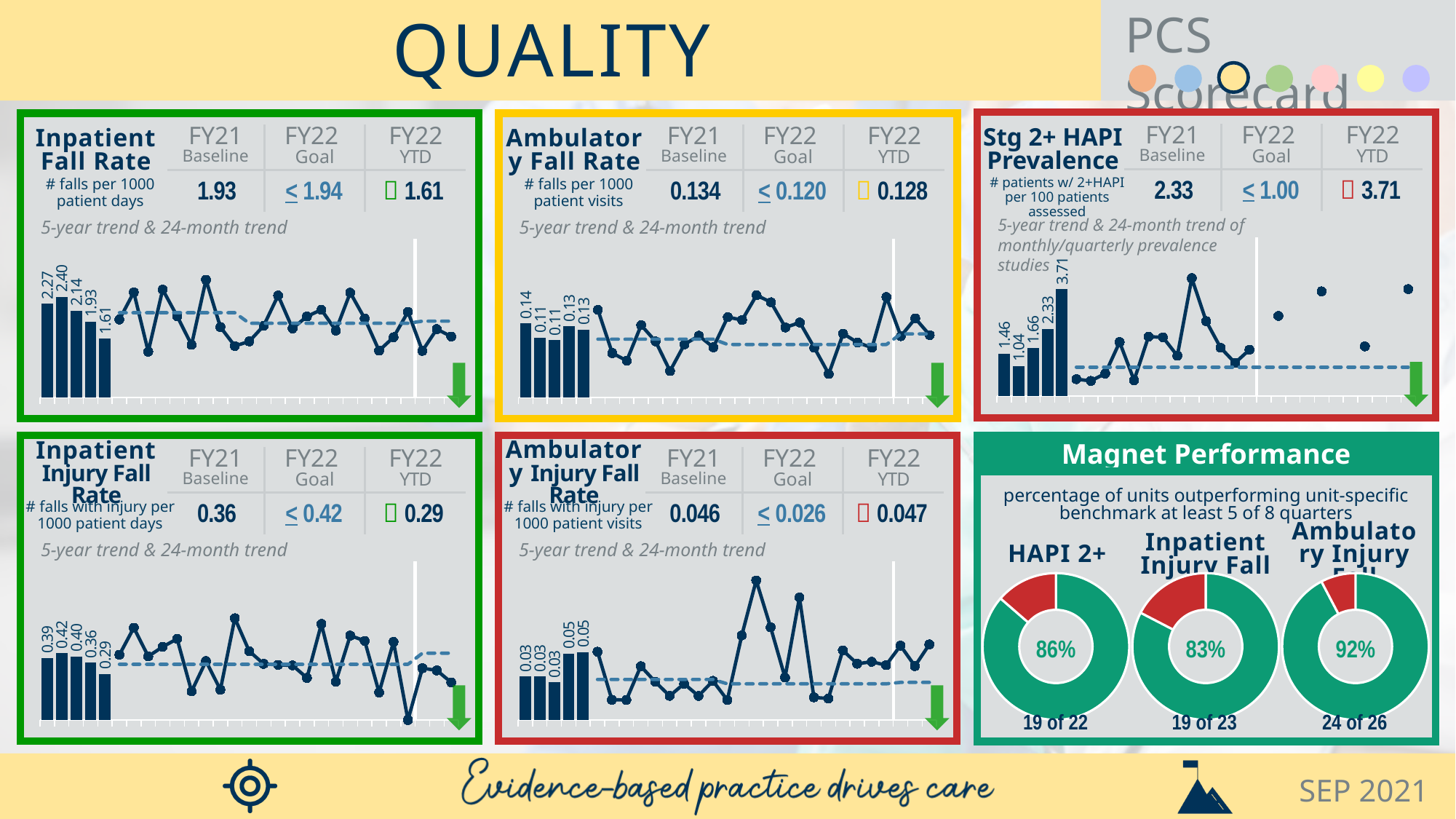
What type of charts are shown in the Magnet Performance section? donut charts In the Magnet Performance section, which donut chart shows the lowest percentage? Inpatient Injury Fall In the Inpatient Fall Rate chart, what is the value of the last (most recent) bar in the 5-year trend? 1.61 Do the bars in the Inpatient Fall Rate 5-year trend generally rise or fall from left to right? fall In the Ambulatory Injury Fall Rate chart, what is the value of the last bar in the 5-year trend? 0.05 In the Inpatient Fall Rate chart, what is the value of the highest bar in the 5-year trend? 2.40 In the Inpatient Injury Fall Rate chart, which is larger: the first bar (0.39) or the last bar (0.29)? 0.39 In the Ambulatory Fall Rate chart, what is the value of the first bar in the 5-year trend? 0.14 In the Inpatient Injury Fall Rate chart, how many bars are in the 5-year trend? 5 In the Stg 2+ HAPI Prevalence chart, what is the value of the lowest bar in the 5-year trend? 1.04 In the Stg 2+ HAPI Prevalence chart, what is the difference between the last bar (3.71) and the first bar (1.46)? 2.25 In the Magnet Performance section, what percentage is shown in the Ambulatory Injury Fall donut chart? 92%